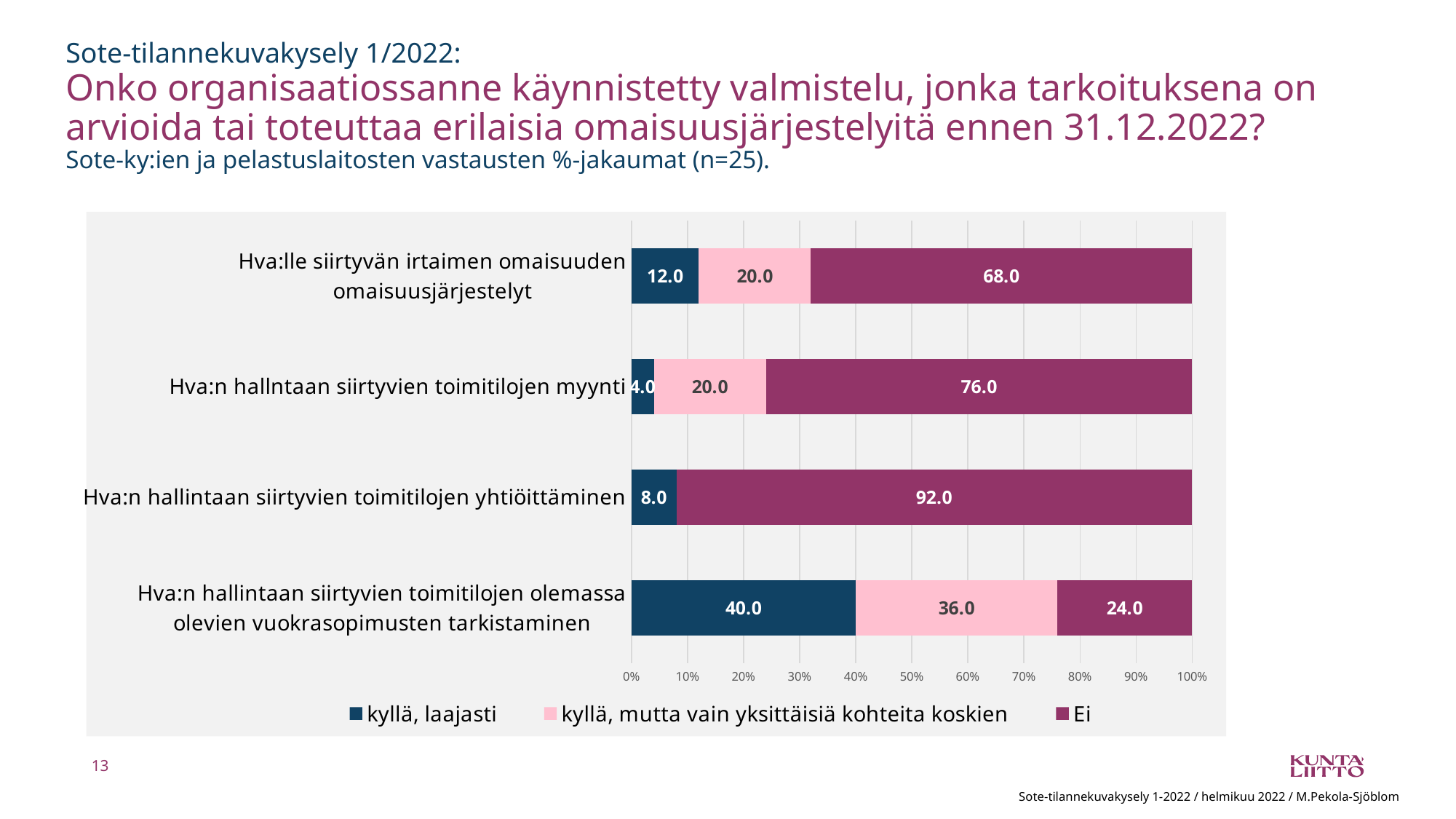
How many categories are shown on the chart? 4 Which category has the highest value for "Ei"? Hva:n hallintaan siirtyvien toimitilojen yhtiöittäminen What is the value of "kyllä, laajasti" for "Hva:n hallintaan siirtyvien toimitilojen olemassa olevien vuokrasopimusten tarkistaminen"? 40.0 How many series does the legend list? 3 What kind of chart is shown on the slide? Stacked bar chart What is the value of "Ei" for "Hva:n hallintaan siirtyvien toimitilojen yhtiöittäminen"? 92.0 Which is larger: the "kyllä, laajasti" value for "Hva:lle siirtyvän irtaimen omaisuuden omaisuusjärjestelyt" or for "Hva:n hallintaan siirtyvien toimitilojen yhtiöittäminen"? Hva:lle siirtyvän irtaimen omaisuuden omaisuusjärjestelyt Which category has the lowest value for "kyllä, laajasti"? Hva:n hallntaan siirtyvien toimitilojen myynti What is the total of the stacked bar for "Hva:n hallintaan siirtyvien toimitilojen olemassa olevien vuokrasopimusten tarkistaminen"? 100.0 What is the difference between the "Ei" values for "Hva:n hallintaan siirtyvien toimitilojen yhtiöittäminen" and "Hva:lle siirtyvän irtaimen omaisuuden omaisuusjärjestelyt"? 24.0 What is the value of "kyllä, mutta vain yksittäisiä kohteita koskien" for "Hva:lle siirtyvän irtaimen omaisuuden omaisuusjärjestelyt"? 20.0 What is the value of "Ei" for "Hva:n hallntaan siirtyvien toimitilojen myynti"? 76.0